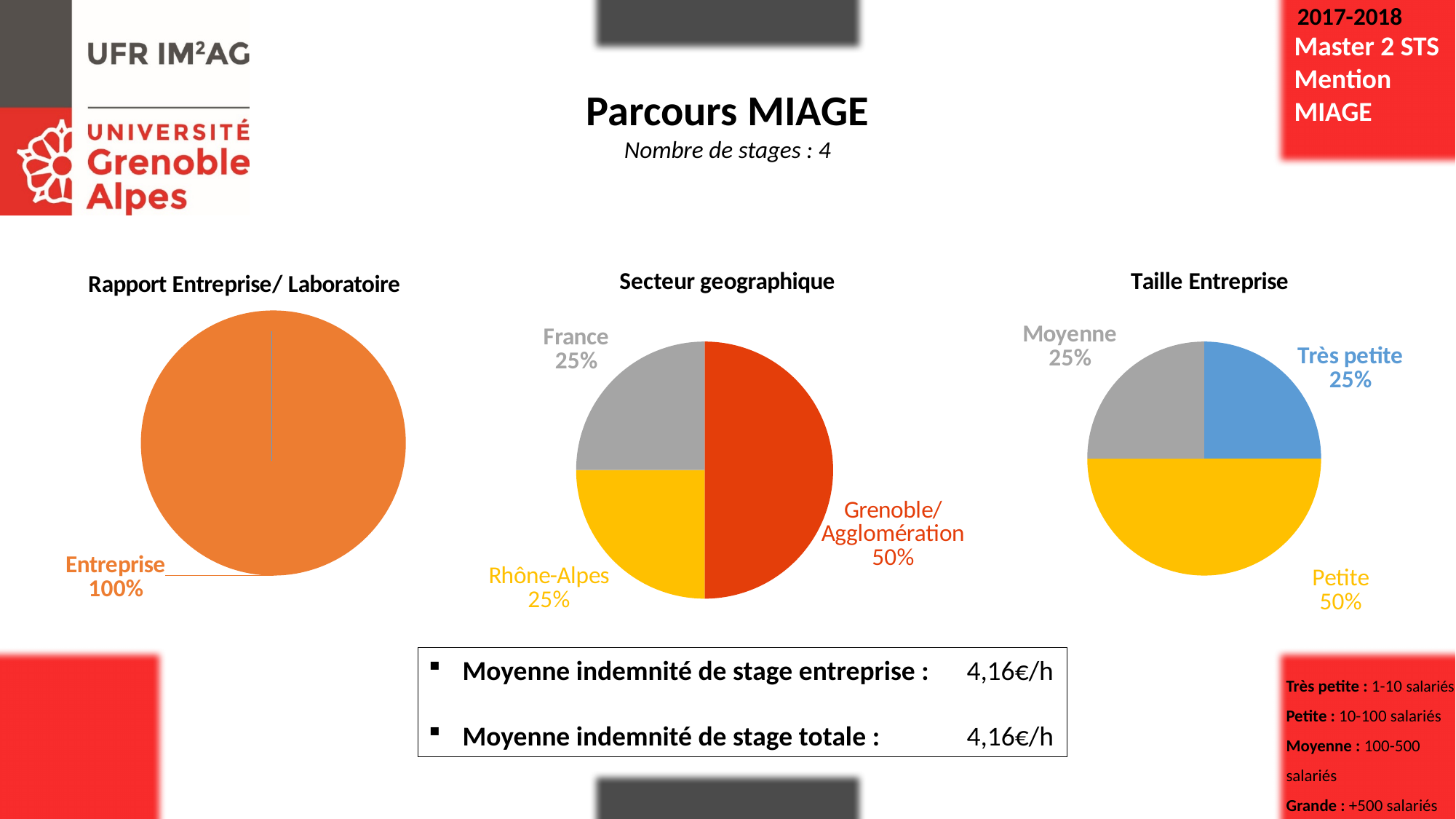
In the 'Taille Entreprise' chart, which category has the largest share? Petite How many categories are shown in the 'Secteur geographique' chart? 3 In the 'Taille Entreprise' chart, which is larger: Petite or Moyenne? Petite How many charts are shown on the slide? 3 In the 'Secteur geographique' chart, what share does Grenoble/Agglomération have? 50% In the 'Secteur geographique' chart, what share does Rhône-Alpes have? 25% In the 'Rapport Entreprise/ Laboratoire' chart, what share does Entreprise have? 100% In the 'Secteur geographique' chart, what is the difference between the shares of Grenoble/Agglomération and France? 25% In the 'Secteur geographique' chart, which category has the largest share? Grenoble/Agglomération In the 'Taille Entreprise' chart, what share does Petite have? 50% What kind of chart is the 'Taille Entreprise' chart? Pie chart In the 'Taille Entreprise' chart, what share does Très petite have? 25%